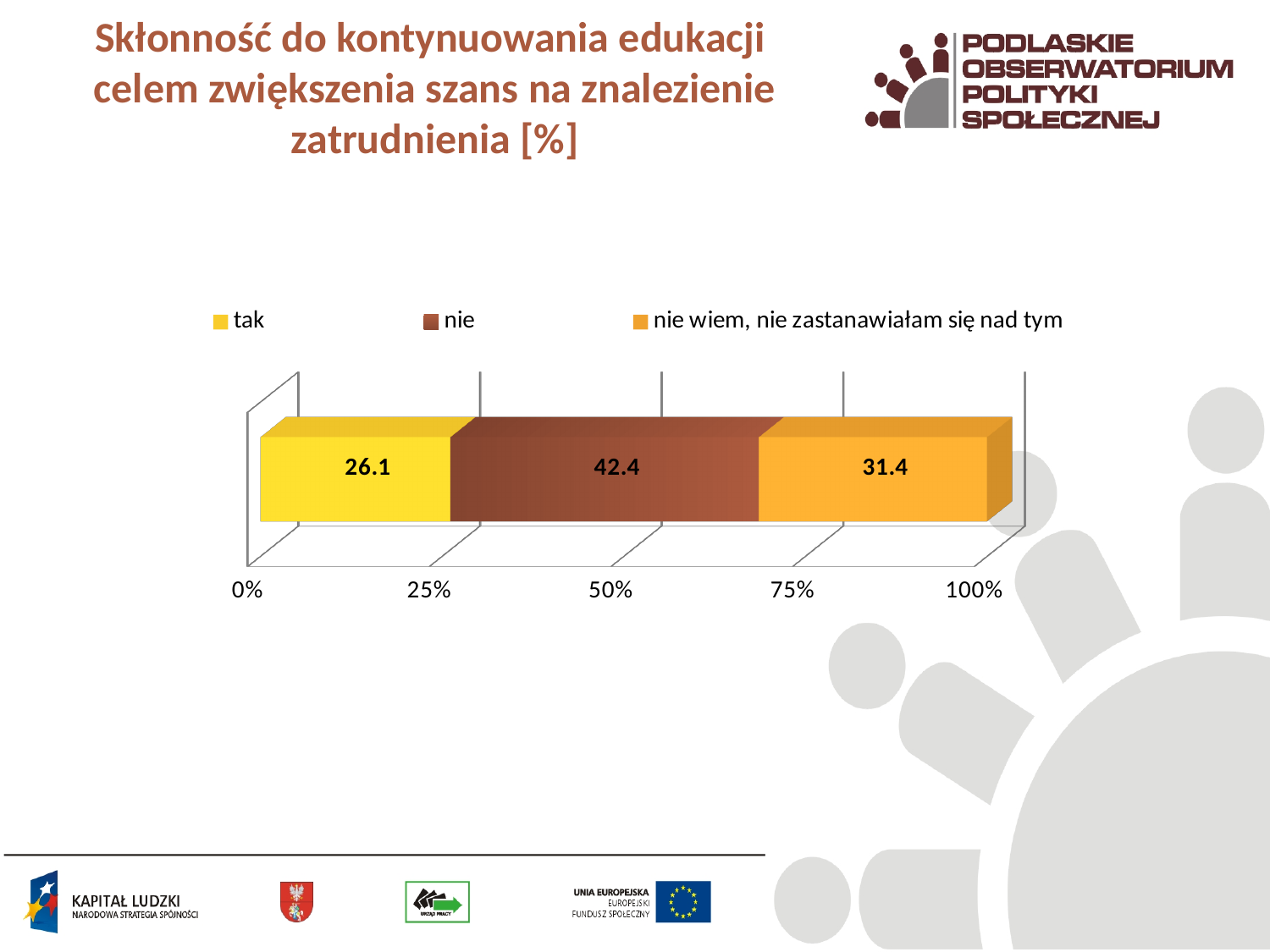
Which response has the highest value? nie What kind of chart is shown on the slide? stacked bar chart What is the difference between the values for "nie" and "tak"? 16.3 What is the value for "tak"? 26.1 What is the highest tick label on the horizontal axis? 100% How many series does the legend list? 3 What is the value for "nie wiem, nie zastanawiałam się nad tym"? 31.4 What is the value for "nie"? 42.4 Which is larger, the value for "nie wiem, nie zastanawiałam się nad tym" or the value for "tak"? nie wiem, nie zastanawiałam się nad tym What colour represents "nie" in the chart? brown What is the total of the stacked bar? 99.9 Which response has the lowest value? tak